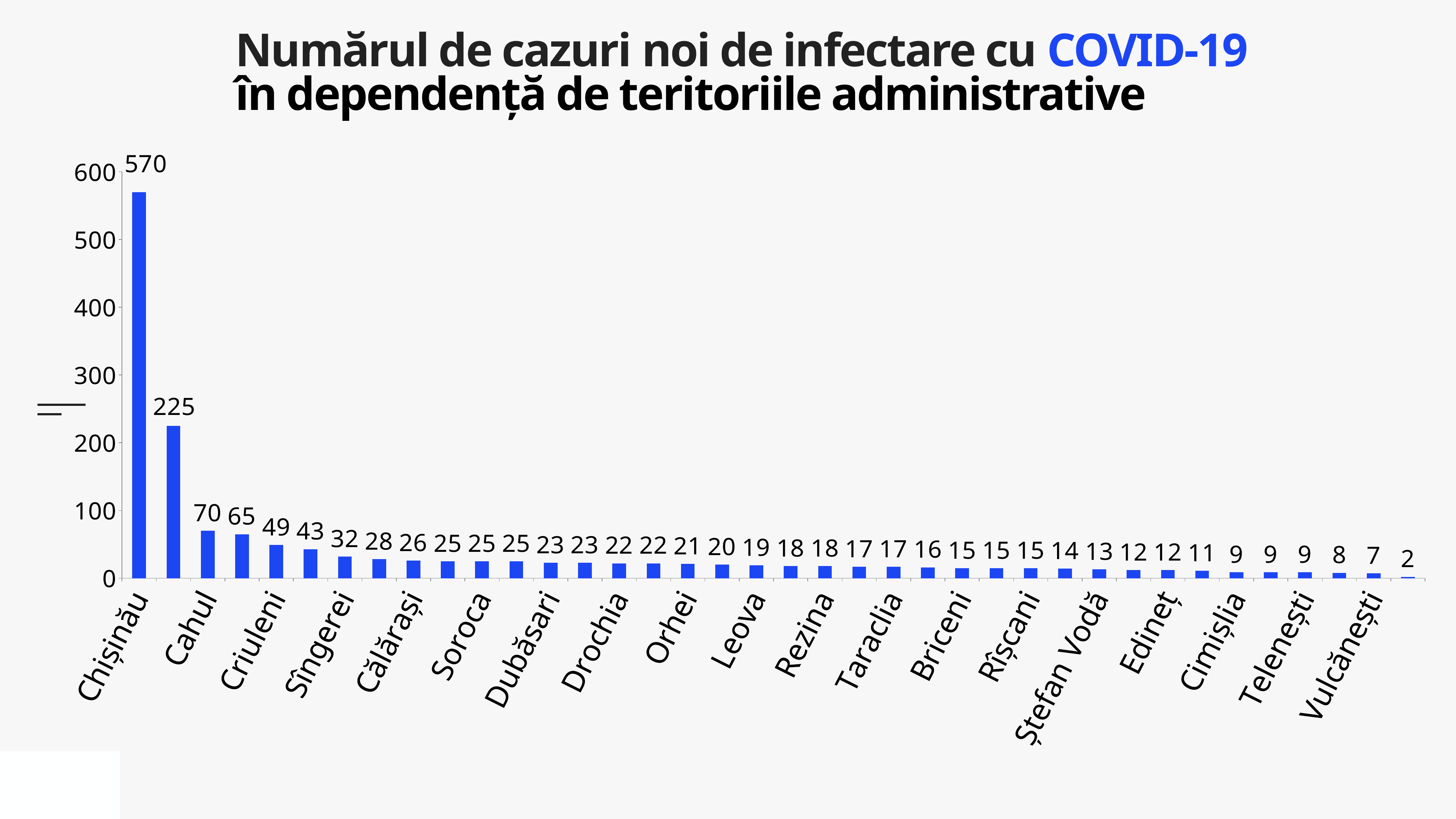
Do the values rise or fall from left to right along the x axis? fall Is the value for Chișinău greater or less than 500? greater What is the difference between the two tallest bars (570 and 225)? 345 How many bars are plotted on the chart? 38 Which category has the highest value? Chișinău What kind of chart is shown? bar chart Which is larger, the value for Chișinău or the value for Cahul? Chișinău What is the title of the chart? Numărul de cazuri noi de infectare cu COVID-19 în dependență de teritoriile administrative What is the value for Vulcănești? 7 What is the smallest value shown on the chart? 2 What is the value for Chișinău? 570 Is the value for Cahul greater or less than 100? less